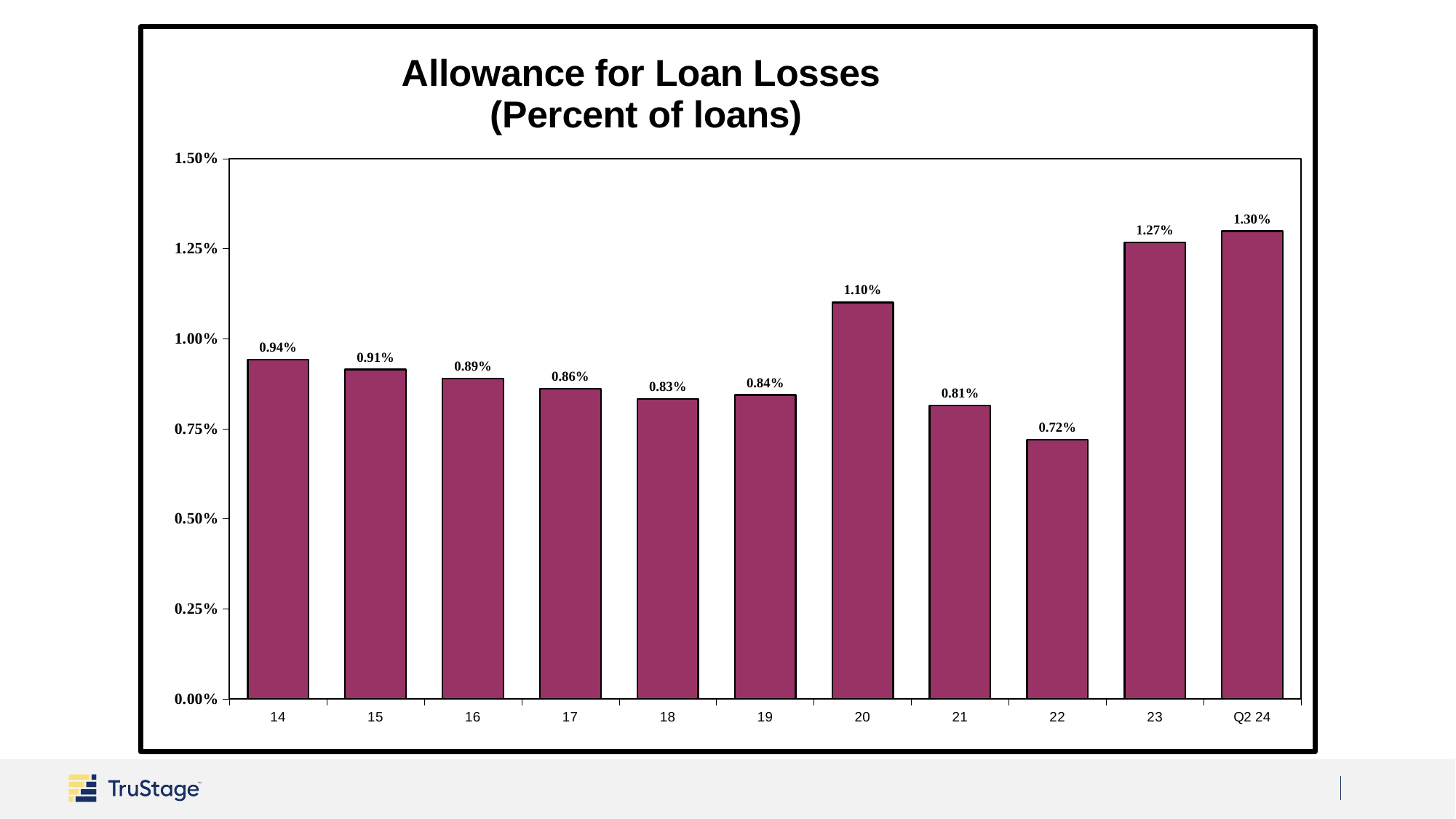
What is the allowance for loan losses as a percent of loans in 20? 1.10% What is the value shown for Q2 24? 1.30% What kind of chart is shown on the slide? bar chart How many categories are shown on the x axis? 11 Which category has the highest allowance for loan losses? Q2 24 Which category has the lowest allowance for loan losses? 22 What is the value shown for 18? 0.83% Which is larger, the value for 14 or the value for 15? 14 What is the difference between the values for 23 and 22? 0.55% Is the value for 21 greater or less than 1.00%? less Do the values rise or fall from 14 to 18? fall What is the title of the chart? Allowance for Loan Losses (Percent of loans)